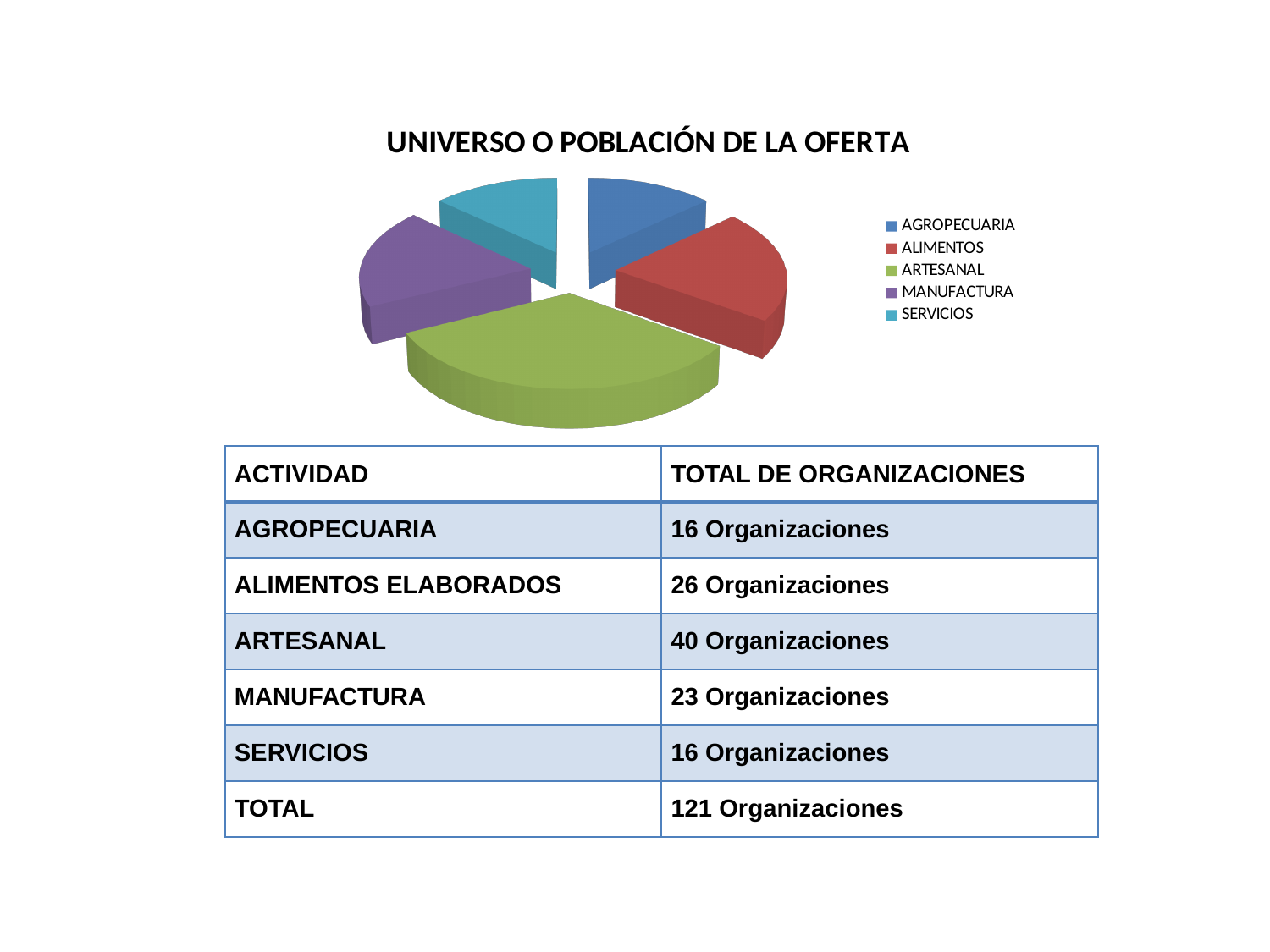
According to the table on the slide, how many organizations are in the ARTESANAL category? 40 Organizaciones What is the title of the chart? UNIVERSO O POBLACIÓN DE LA OFERTA Using the values in the table, how many more organizations are in ARTESANAL than in ALIMENTOS ELABORADOS? 14 Which category has the largest slice of the pie chart? ARTESANAL According to the table on the slide, what is the total number of organizations? 121 Organizaciones How many entries does the chart legend list? 5 Which slice is larger, ARTESANAL or MANUFACTURA? ARTESANAL What colour is the ARTESANAL slice in the pie chart? green What kind of chart is shown on the slide? pie chart According to the table on the slide, how many organizations are in the MANUFACTURA category? 23 Organizaciones Which slice is larger, ALIMENTOS or AGROPECUARIA? ALIMENTOS How many slices does the pie chart have? 5